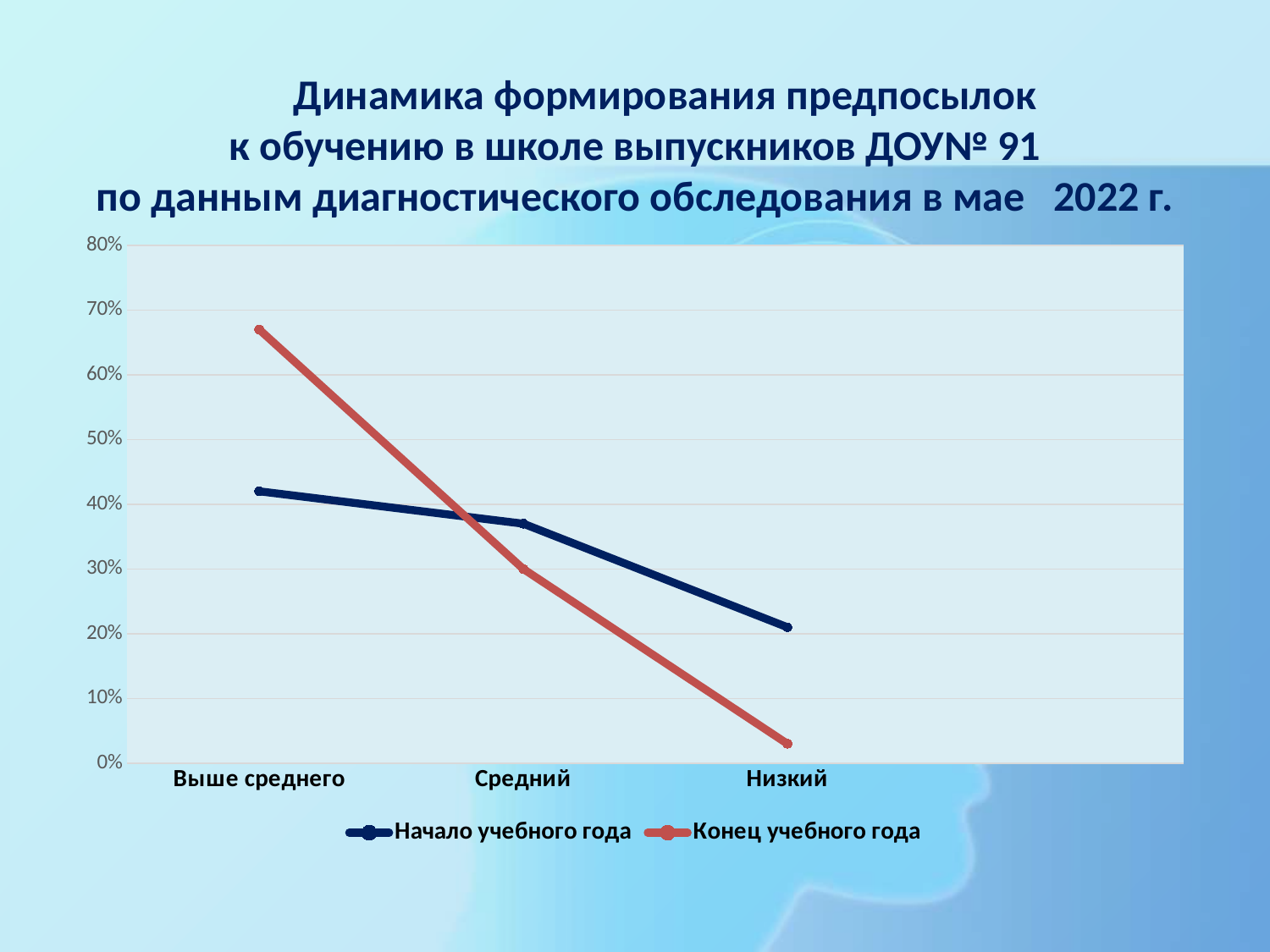
Which category has the lowest value for the series "Начало учебного года"? Низкий Is the value for "Низкий" in the series "Конец учебного года" greater or less than 10%? less Do the values of the series "Конец учебного года" rise or fall from "Выше среднего" to "Низкий"? fall Which category has the highest value for the series "Конец учебного года"? Выше среднего For the category "Низкий", which series has the larger value: "Начало учебного года" or "Конец учебного года"? Начало учебного года For the category "Выше среднего", which series has the larger value: "Начало учебного года" or "Конец учебного года"? Конец учебного года What kind of chart is shown on the slide? line chart Is the value for "Низкий" in the series "Начало учебного года" greater or less than 30%? less Is the value for "Выше среднего" in the series "Конец учебного года" greater or less than 60%? greater How many categories are shown on the x axis? 3 How many series does the legend list? 2 What colour is the line for the series "Конец учебного года"? red